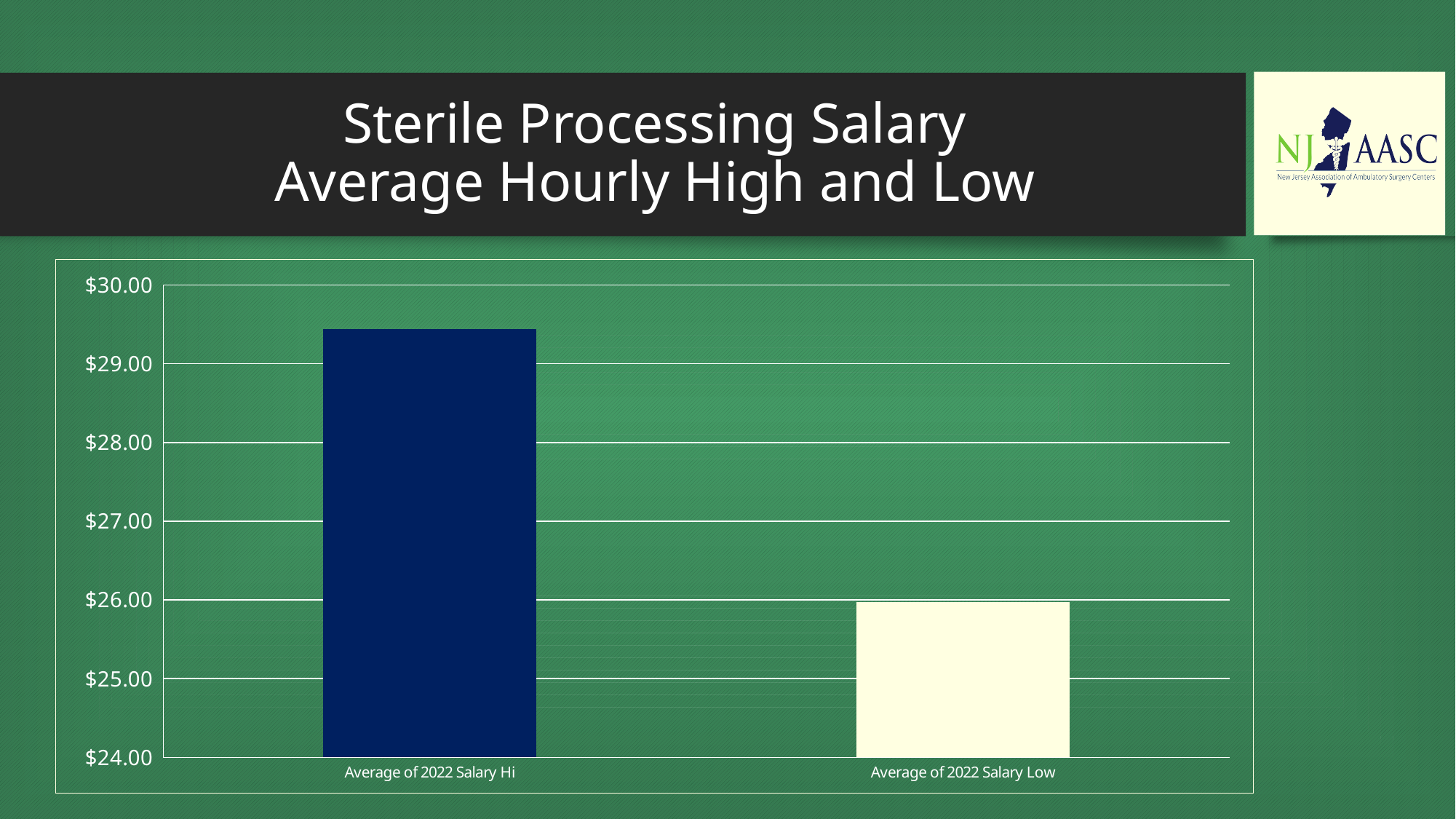
How many bars are plotted in the chart? 2 Is the value for Average of 2022 Salary Hi greater or less than $29.00? greater Which category has the lowest value in the chart? Average of 2022 Salary Low What is the title of the slide containing the chart? Sterile Processing Salary Average Hourly High and Low Is the value for Average of 2022 Salary Hi greater or less than $30.00? less Is the value for Average of 2022 Salary Low greater or less than $25.00? greater Which category has the highest value in the chart? Average of 2022 Salary Hi What kind of chart is shown on the slide? Bar chart What is the highest value shown on the vertical axis of the chart? $30.00 Which is larger, the value for Average of 2022 Salary Hi or the value for Average of 2022 Salary Low? Average of 2022 Salary Hi